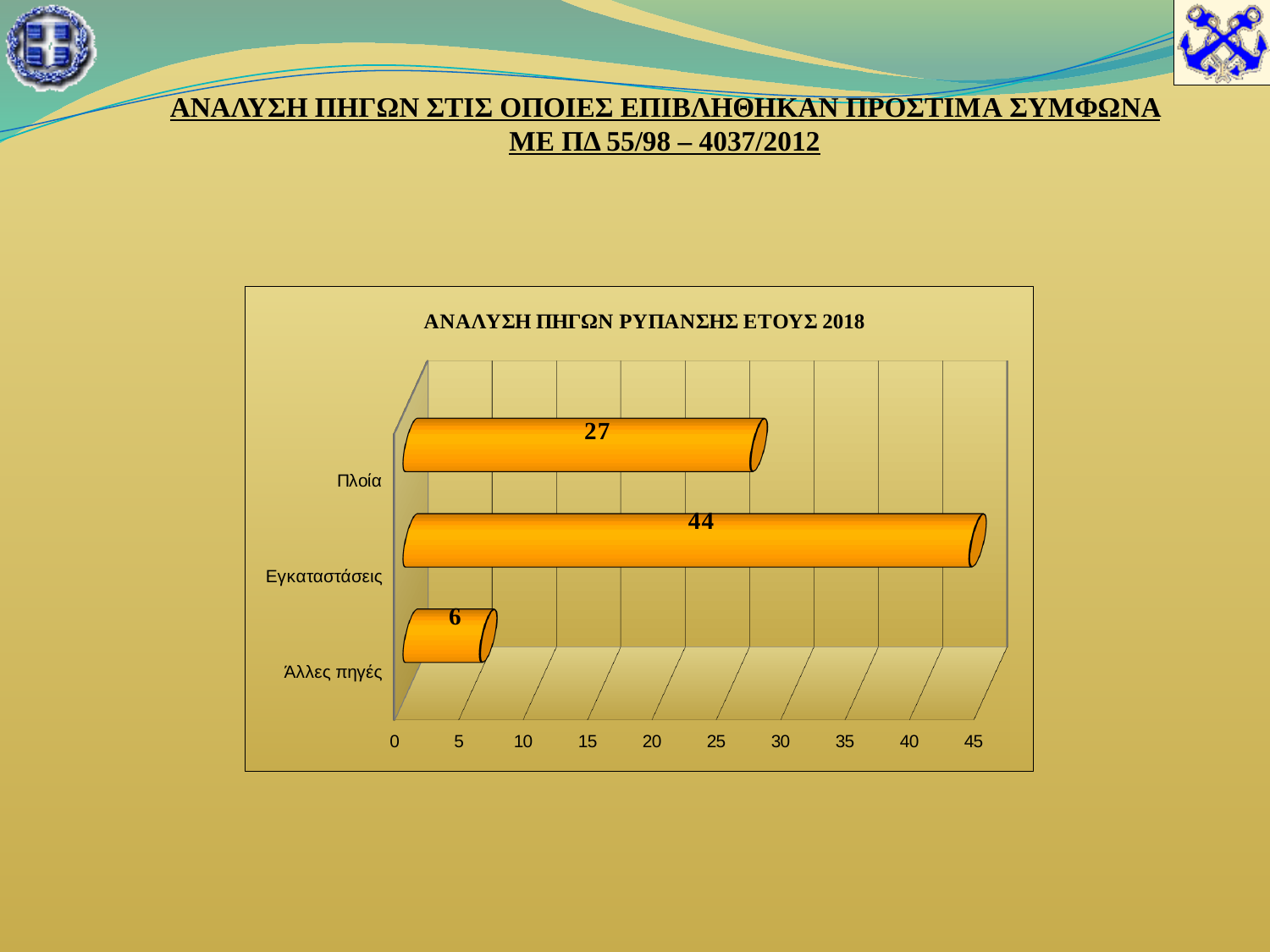
What is the value for Άλλες πηγές? 6 Which category has the highest value? Εγκαταστάσεις Which is larger, the value for Πλοία or the value for Άλλες πηγές? Πλοία What is the value for Εγκαταστάσεις? 44 What is the value for Πλοία? 27 How many categories are shown in the chart? 3 What is the difference between the values for Εγκαταστάσεις and Πλοία? 17 What is the difference between the values for Πλοία and Άλλες πηγές? 21 What is the title of the chart? ΑΝΑΛΥΣΗ ΠΗΓΩΝ ΡΥΠΑΝΣΗΣ ΕΤΟΥΣ 2018 Which category has the lowest value? Άλλες πηγές What kind of chart is shown on the slide? bar chart Is the value for Εγκαταστάσεις greater or less than 40? greater